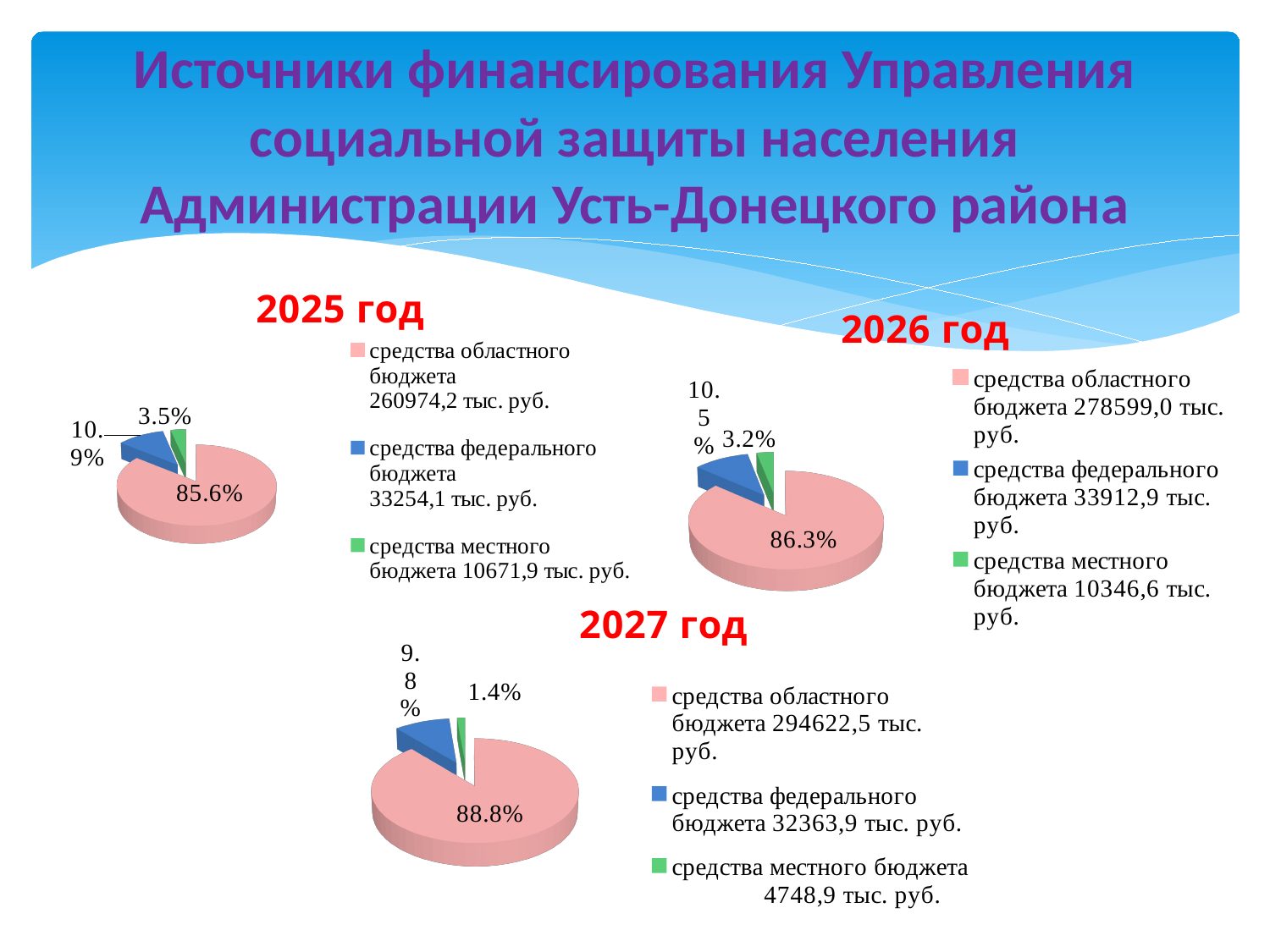
On the 2025 год chart, what is the difference between the shares of средства областного бюджета and средства федерального бюджета? 74.7% On the 2026 год pie chart, what share is shown for средства местного бюджета? 3.2% On the 2027 год pie chart, which source has the largest share? средства областного бюджета On the 2027 год pie chart, what share is shown for средства местного бюджета? 1.4% On the 2025 год pie chart, what share is shown for средства федерального бюджета? 10.9% How many slices does the 2027 год pie chart have? 3 On the 2026 год pie chart, which source has the smallest share? средства местного бюджета What type of chart is used for 2025 год? pie chart